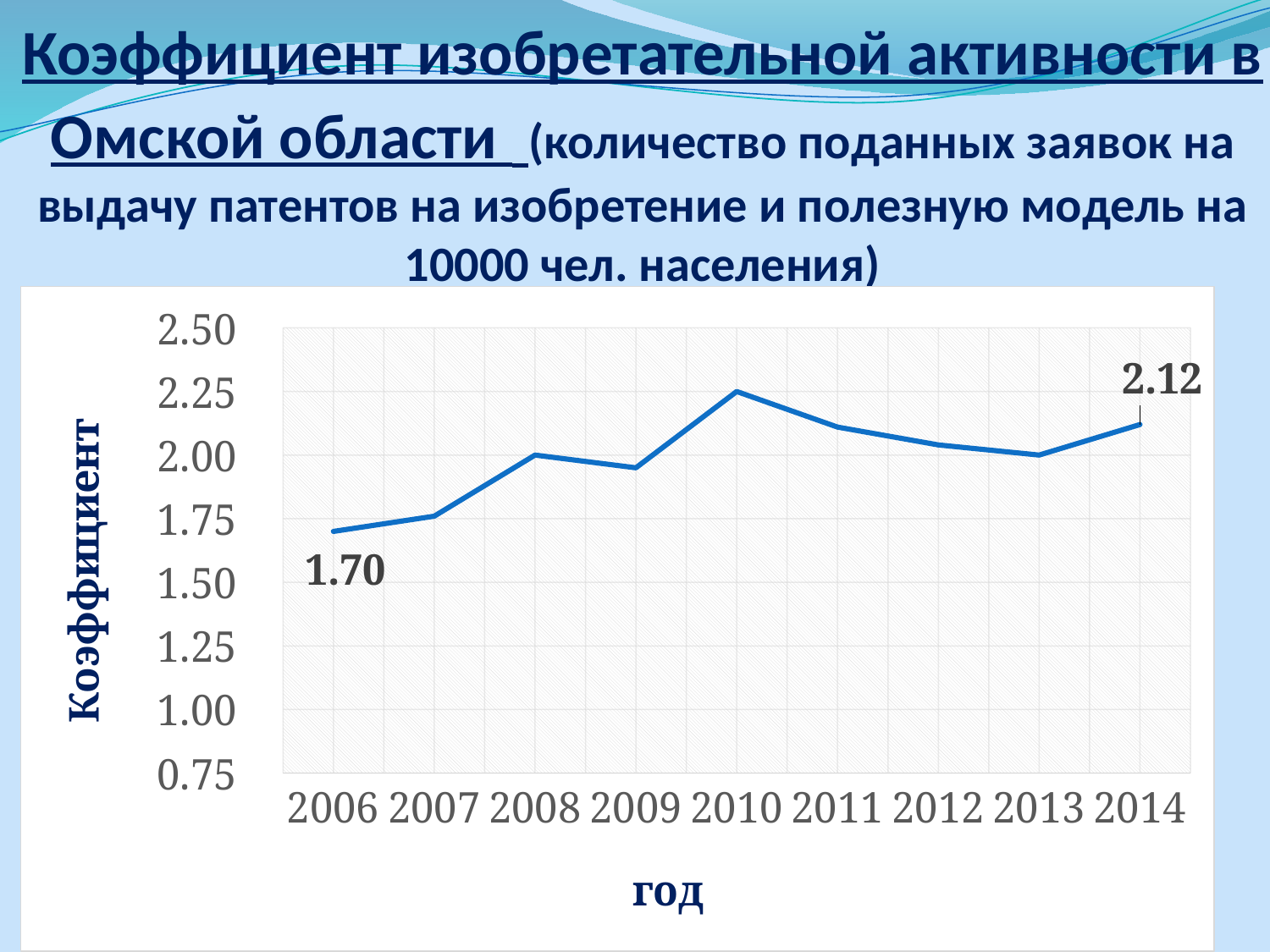
What is the value of the coefficient for 2006? 1.70 What is the title of the vertical axis? Коэффициент In which year is the coefficient highest? 2010 By how much did the coefficient increase from 2006 to 2014? 0.42 Which year has the higher coefficient, 2006 or 2014? 2014 What kind of chart is shown on the slide? line chart How many years are shown on the x axis? 9 What is the value of the coefficient for 2014? 2.12 Is the value for 2011 greater or less than 2.00? greater In which year is the coefficient lowest? 2006 Is the value for 2010 greater or less than 2.00? greater Is the value for 2007 greater or less than 2.00? less